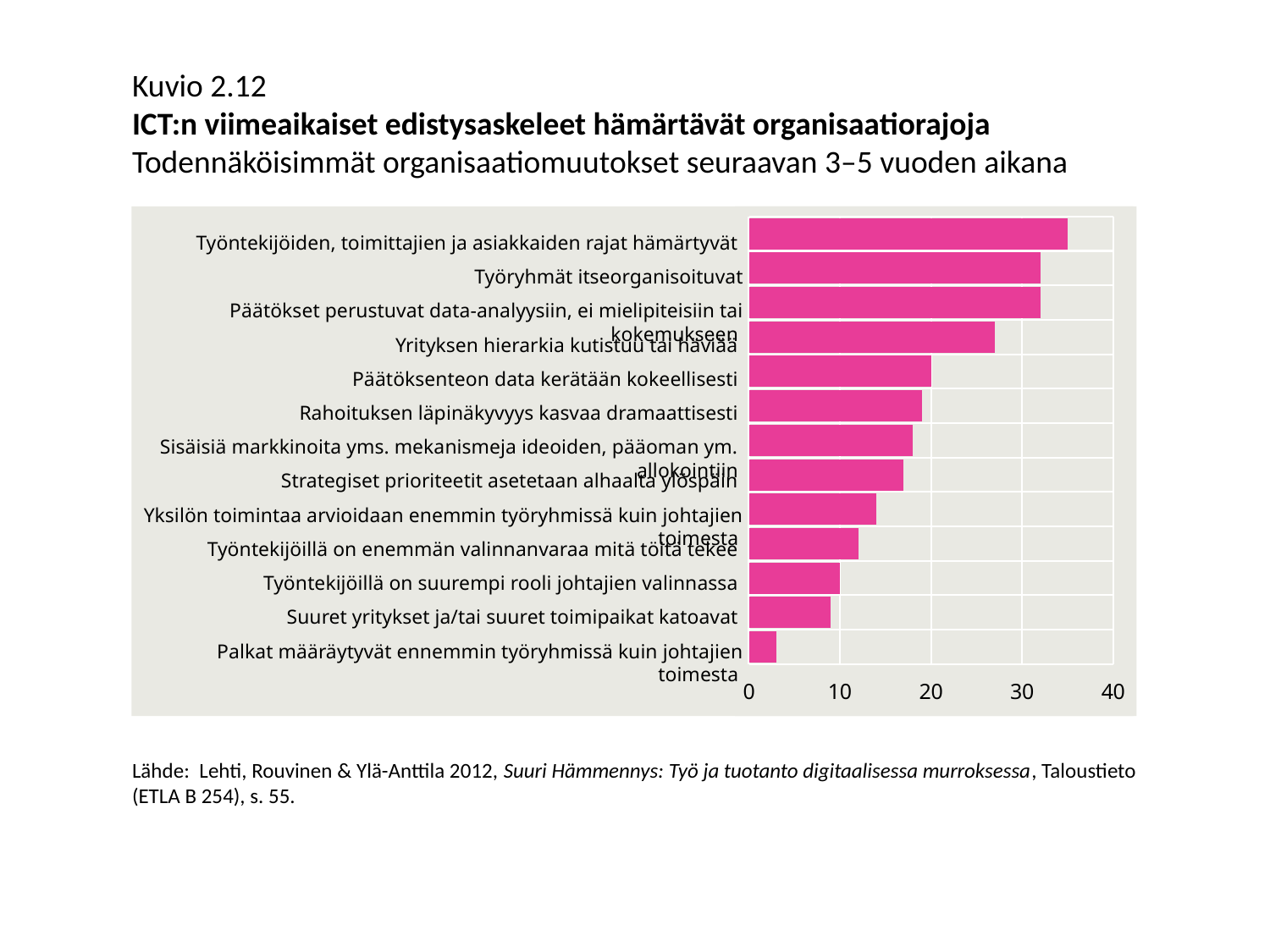
What is the figure number given above the chart title? Kuvio 2.12 Which category has the lowest value? Palkat määräytyvät ennemmin työryhmissä kuin johtajien toimesta Which has the larger value: "Yrityksen hierarkia kutistuu tai häviää" or "Päätöksenteon data kerätään kokeellisesti"? Yrityksen hierarkia kutistuu tai häviää Which has the larger value: "Työntekijöillä on enemmän valinnanvaraa mitä töitä tekee" or "Suuret yritykset ja/tai suuret toimipaikat katoavat"? Työntekijöillä on enemmän valinnanvaraa mitä töitä tekee Is the value for "Yksilön toimintaa arvioidaan enemmin työryhmissä kuin johtajien toimesta" greater or less than 10? greater Is the value for "Työryhmät itseorganisoituvat" greater or less than 30? greater Is the value for "Työntekijöiden, toimittajien ja asiakkaiden rajat hämärtyvät" greater or less than 30? greater How many categories (bars) does the chart show? 13 Which category has the highest value? Työntekijöiden, toimittajien ja asiakkaiden rajat hämärtyvät What kind of chart is shown on the slide? bar chart